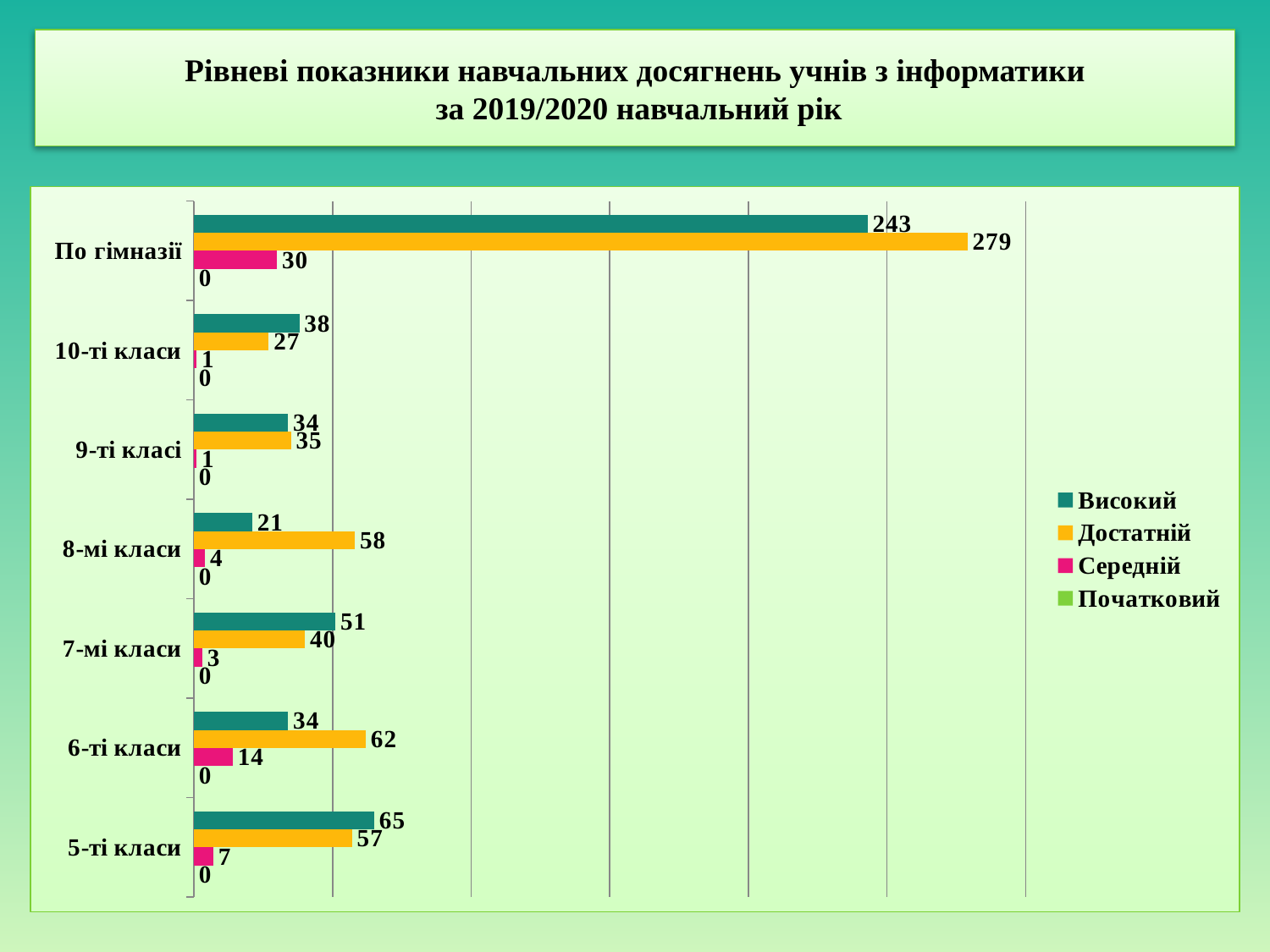
What is the value of Середній for 6-ті класи? 14 What is the value of Високий for 5-ті класи? 65 Which class category has the highest Достатній value (excluding По гімназії)? 6-ті класи How many categories are shown on the vertical axis? 7 What is the value of Початковий for 9-ті класі? 0 What is the value of Достатній for По гімназії? 279 What is the difference between the Достатній and Високий values for По гімназії? 36 How many series does the legend list? 4 What kind of chart is shown on the slide? bar chart What is the value of Високий for 8-мі класи? 21 Which is larger for 7-мі класи: Високий or Достатній? Високий Which class category has the lowest Високий value? 8-мі класи